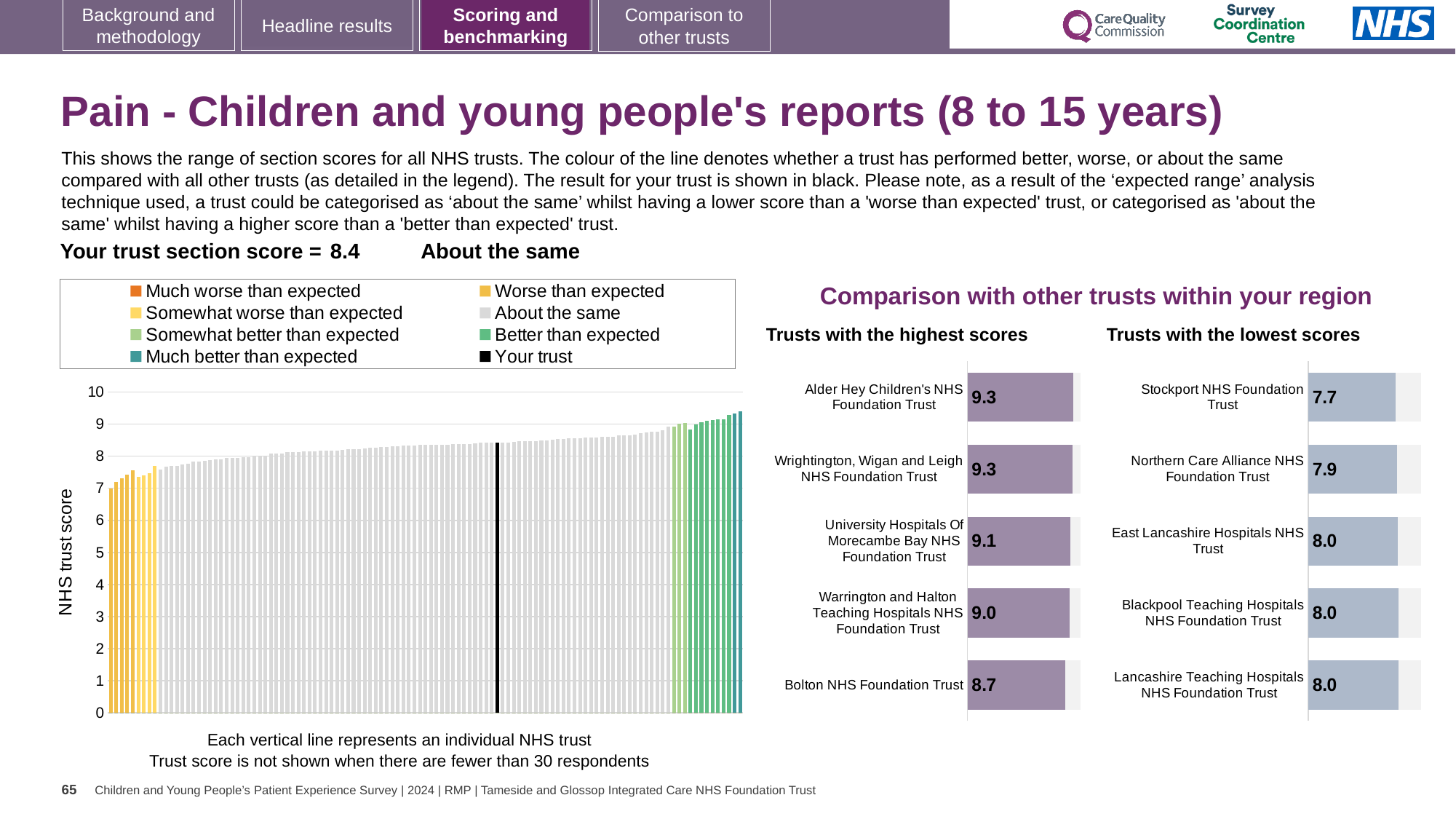
In the 'Trusts with the lowest scores' chart, what is the score for Stockport NHS Foundation Trust? 7.7 In the 'Trusts with the highest scores' chart, what is the score for Bolton NHS Foundation Trust? 8.7 In the 'Trusts with the highest scores' chart, what is the score for Alder Hey Children's NHS Foundation Trust? 9.3 In the main NHS trust score chart on the left, what is the section score for your trust (the black line)? 8.4 In the 'Trusts with the lowest scores' chart, which trust has the lowest score? Stockport NHS Foundation Trust In the 'Trusts with the lowest scores' chart, what is the difference between the score for Northern Care Alliance NHS Foundation Trust and the score for Stockport NHS Foundation Trust? 0.2 In the 'Trusts with the highest scores' chart, which has the higher score: University Hospitals Of Morecambe Bay NHS Foundation Trust or Warrington and Halton Teaching Hospitals NHS Foundation Trust? University Hospitals Of Morecambe Bay NHS Foundation Trust What kind of chart is the main NHS trust score chart on the left? bar chart In the main NHS trust score chart on the left, do the trust scores rise or fall from left to right? rise How many entries does the legend of the main NHS trust score chart on the left list? 8 How many trusts are listed in the 'Trusts with the lowest scores' chart? 5 In the 'Trusts with the highest scores' chart, what is the difference between the score for Alder Hey Children's NHS Foundation Trust and the score for Bolton NHS Foundation Trust? 0.6